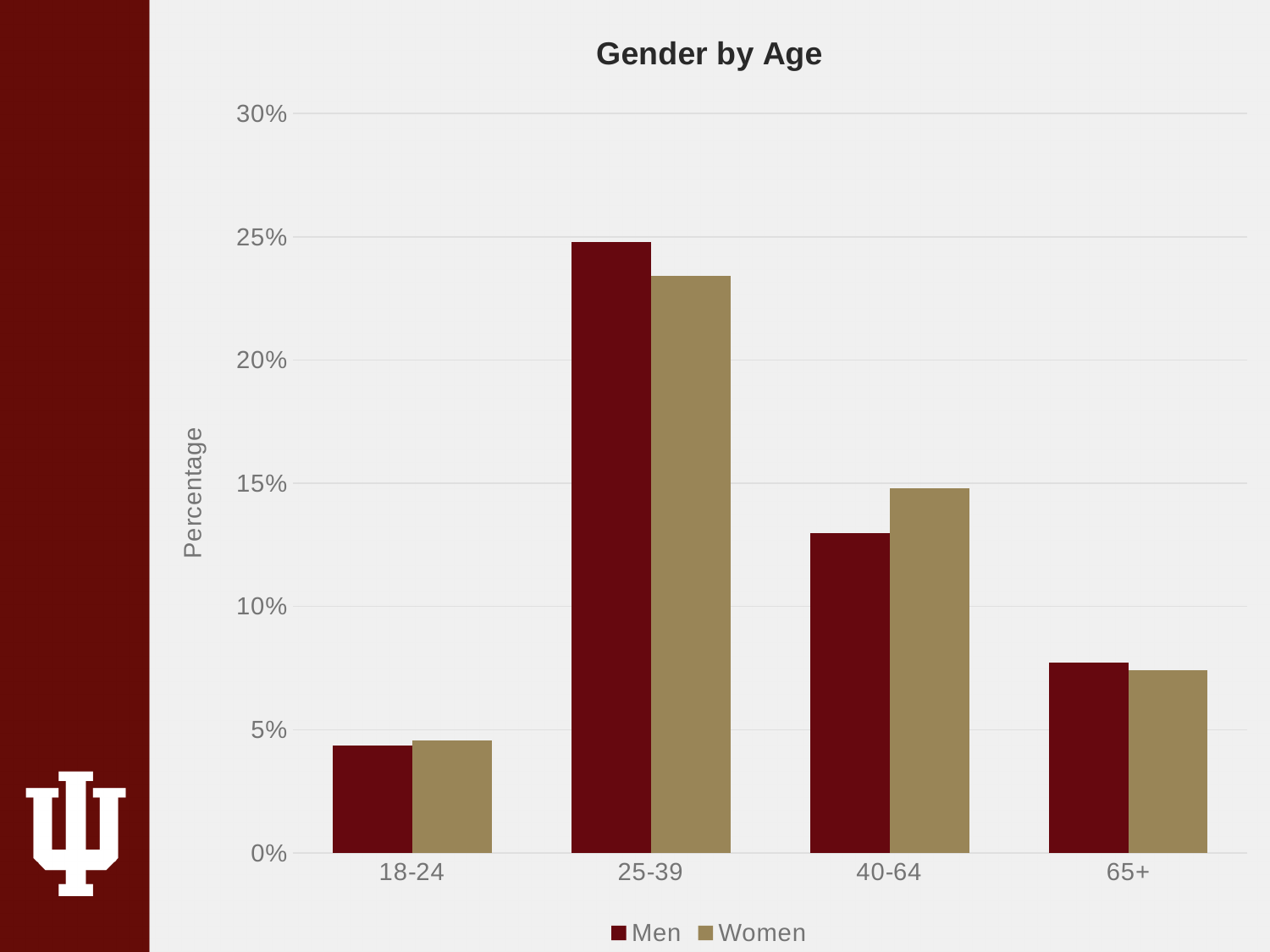
In the 40-64 age group, which is larger, Men or Women? Women Which age group has the highest value for Men? 25-39 Is the value for Men in the 18-24 age group greater or less than 5%? less What is the title of the chart? Gender by Age What is the label of the y axis? Percentage How many age categories are shown on the x axis? 4 How many series does the legend list? 2 What type of chart is shown on the slide? bar chart In the 25-39 age group, which is larger, Men or Women? Men Which age group has the lowest value for Women? 18-24 Is the value for Men in the 25-39 age group greater or less than 20%? greater